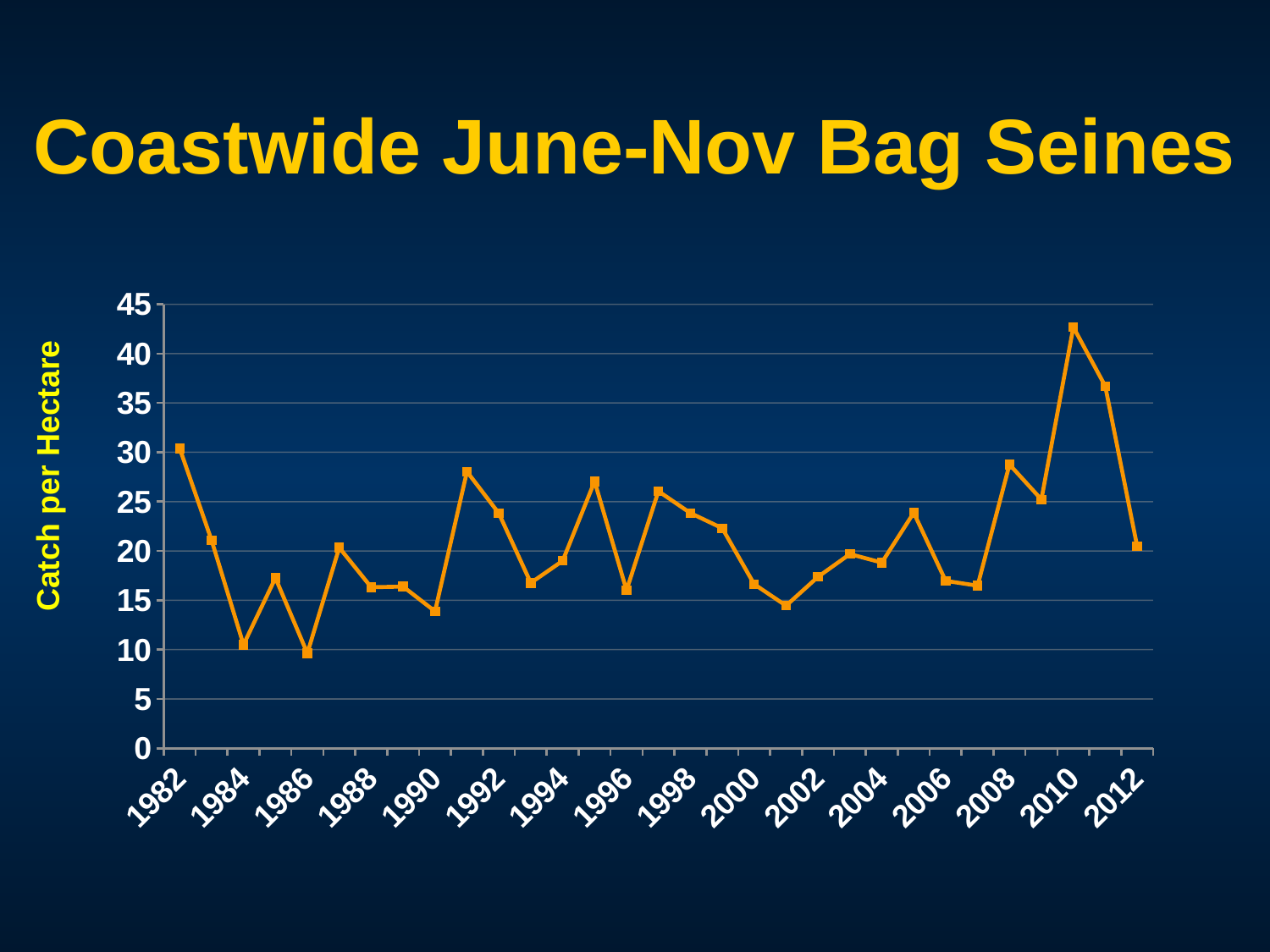
Which is larger, the value for 2010 or the value for 1982? 2010 Is the value for 2001 greater or less than 20? less How many yearly data points are plotted on the chart? 31 What is the label on the vertical axis? Catch per Hectare Is the value for 1991 greater or less than 25? greater Which is larger, the value for 1991 or the value for 1996? 1991 Which year has the highest catch per hectare? 2010 Is the value for 1986 greater or less than 15? less Do the values rise or fall from 2010 to 2012? fall What kind of chart is shown on the slide? line chart